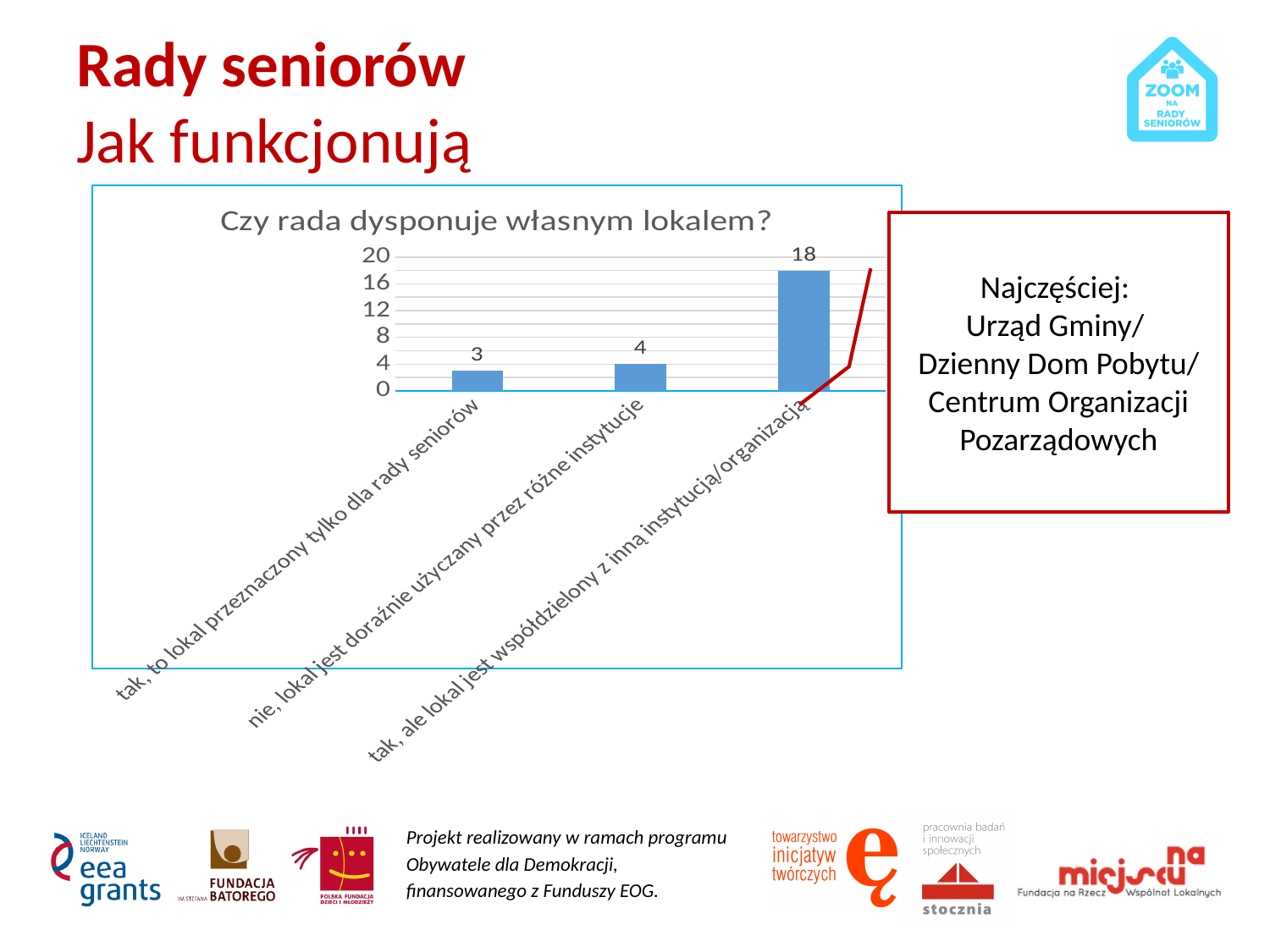
Which category has the highest value? tak, ale lokal jest współdzielony z inną instytucją/organizacją What is the title of the chart? Czy rada dysponuje własnym lokalem? Which is larger: the value for "nie, lokal jest doraźnie użyczany przez różne instytucje" or the value for "tak, to lokal przeznaczony tylko dla rady seniorów"? nie, lokal jest doraźnie użyczany przez różne instytucje What is the value for "nie, lokal jest doraźnie użyczany przez różne instytucje"? 4 What is the value for "tak, to lokal przeznaczony tylko dla rady seniorów"? 3 Is the value for "tak, ale lokal jest współdzielony z inną instytucją/organizacją" greater or less than 12? greater How many categories are shown in the chart? 3 What is the difference between the value for "tak, ale lokal jest współdzielony z inną instytucją/organizacją" and the value for "nie, lokal jest doraźnie użyczany przez różne instytucje"? 14 What is the value for "tak, ale lokal jest współdzielony z inną instytucją/organizacją"? 18 What kind of chart is shown on the slide? bar chart Which category has the lowest value? tak, to lokal przeznaczony tylko dla rady seniorów What is the total of the three values shown in the chart? 25